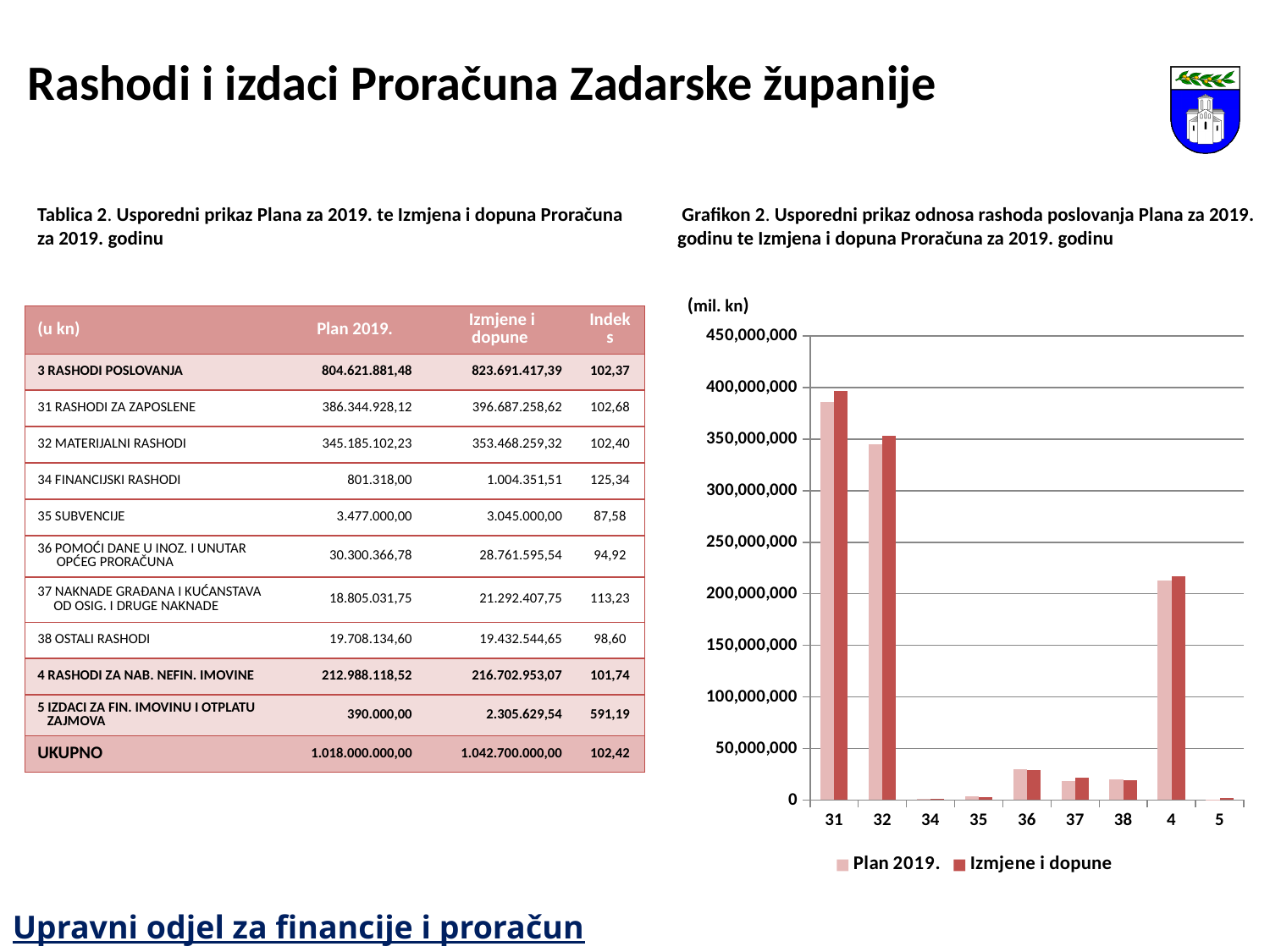
In Grafikon 2, is the Izmjene i dopune value for category 31 greater or less than 350,000,000? greater In Grafikon 2, is the Plan 2019. value for category 31 greater or less than 350,000,000? greater In Grafikon 2, which category has the highest value for Plan 2019.? 31 How many categories are shown on the x axis of Grafikon 2? 9 How many series does the legend of Grafikon 2 list? 2 In Grafikon 2, which is larger for Plan 2019.: category 36 or category 37? 36 What kind of chart is Grafikon 2 on the slide? bar chart In Grafikon 2, which is larger for Plan 2019.: category 32 or category 4? 32 In Grafikon 2, which category has the highest value for Izmjene i dopune? 31 In Grafikon 2, is the Plan 2019. value for category 4 greater or less than 200,000,000? greater What are the two legend entries of Grafikon 2? Plan 2019. and Izmjene i dopune